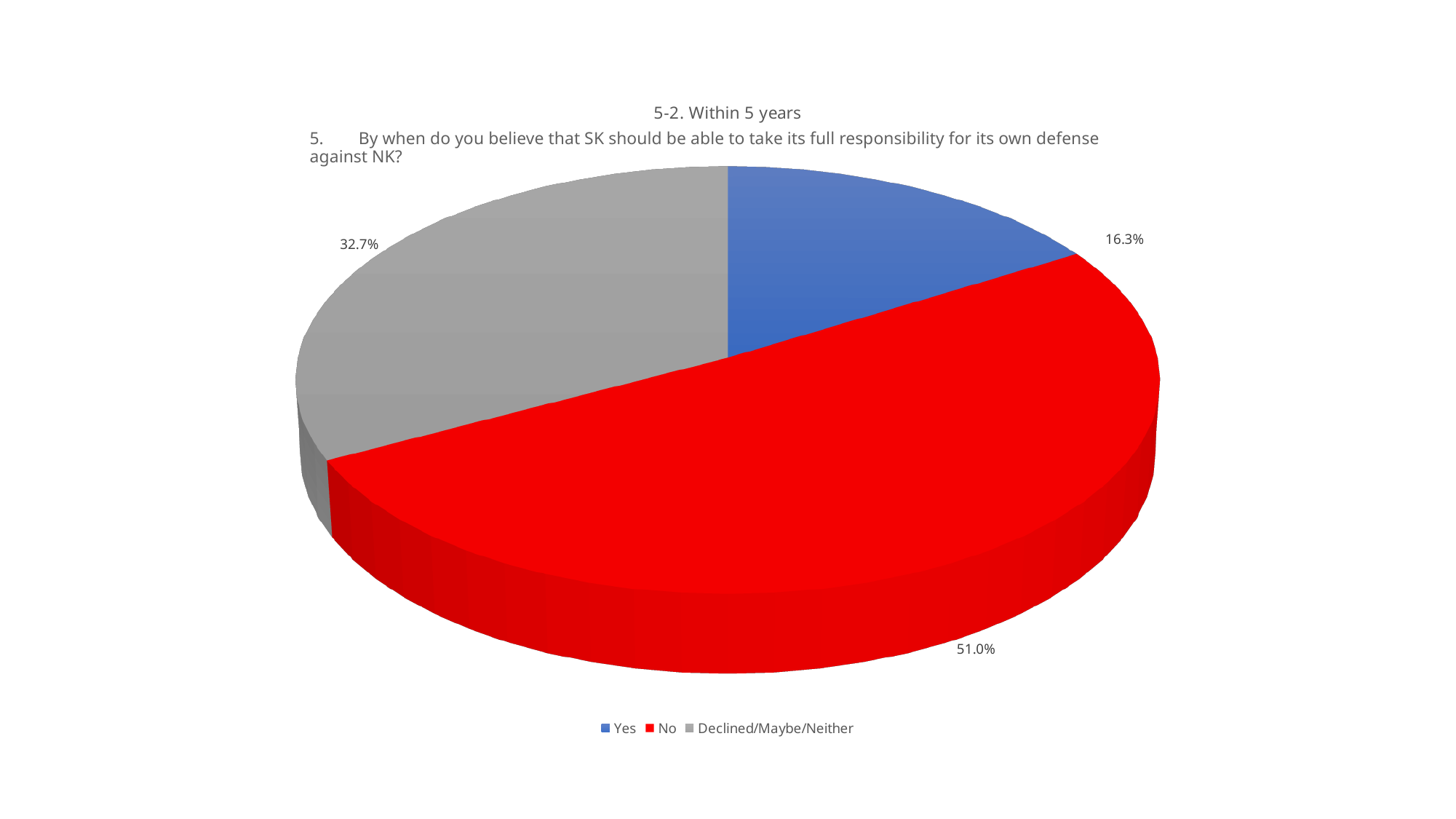
What is the difference in percentage points between the "No" slice and the "Declined/Maybe/Neither" slice? 18.3 How many categories does the legend list? 3 What percentage of the pie is the "Declined/Maybe/Neither" slice? 32.7% Which category has the smallest share of the pie? Yes Which category has the largest share of the pie? No What is the difference in percentage points between the "No" slice and the "Yes" slice? 34.7 What percentage of the pie is the "Yes" slice? 16.3% What is the title of the chart? 5-2. Within 5 years What percentage of the pie is the "No" slice? 51.0% What colour is the "No" slice? red What kind of chart is shown on the slide? pie chart Which is larger, the "Declined/Maybe/Neither" slice or the "Yes" slice? Declined/Maybe/Neither